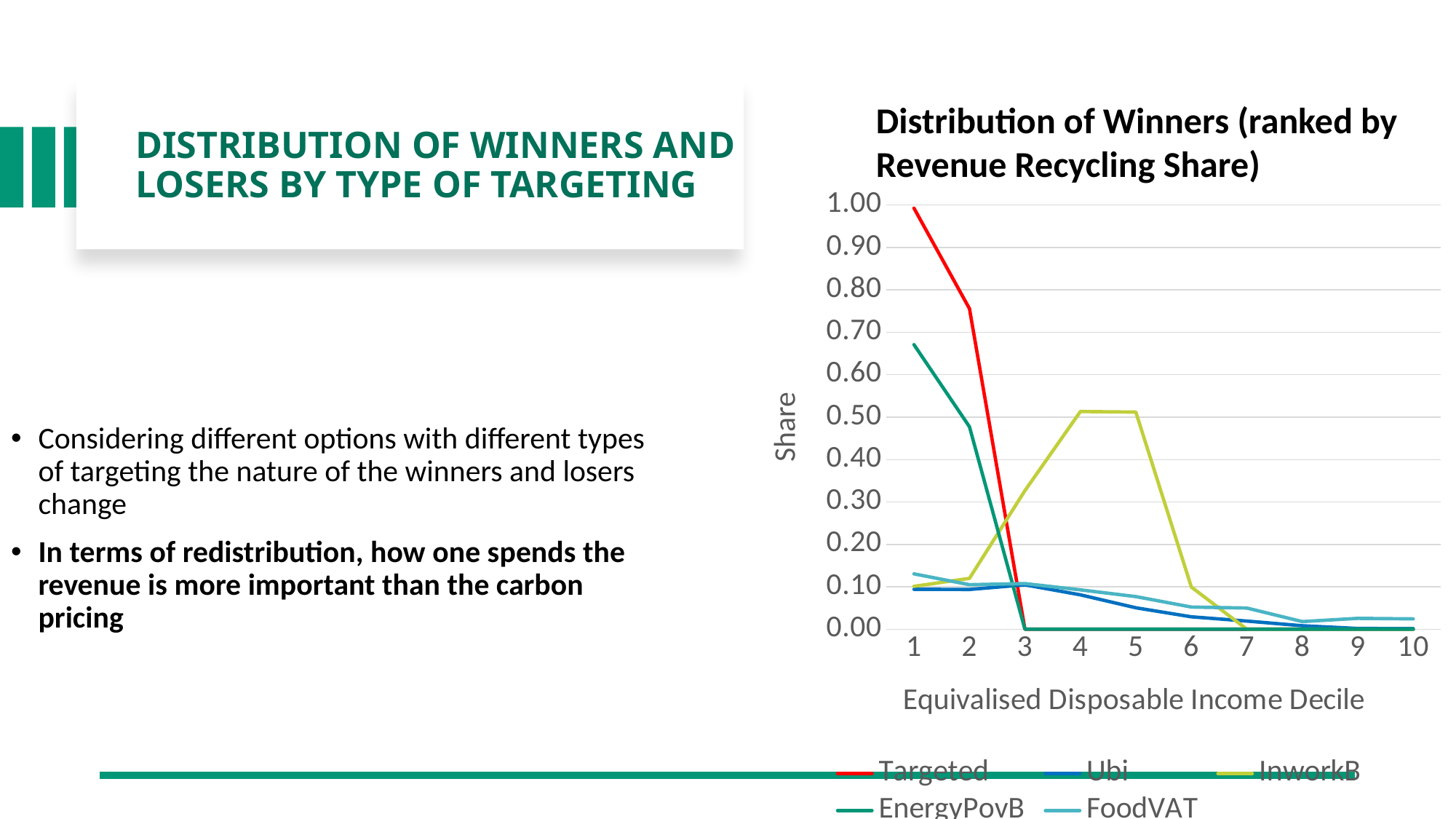
What kind of chart is shown on the slide? line chart How many series does the legend of the chart list? 5 At decile 1, which is larger: the value for Targeted or the value for EnergyPovB? Targeted Is the value for InworkB at decile 6 greater or less than 0.20? less Which series reaches its peak at deciles 4 and 5? InworkB How many income deciles are shown along the x axis of the chart? 10 Is the value for InworkB at decile 4 greater or less than 0.40? greater Does the Targeted series rise or fall from decile 1 to decile 3? fall What is the title of the x axis of the chart? Equivalised Disposable Income Decile Is the value for Targeted at decile 1 greater or less than 0.90? greater Which series has the highest value at decile 1? Targeted